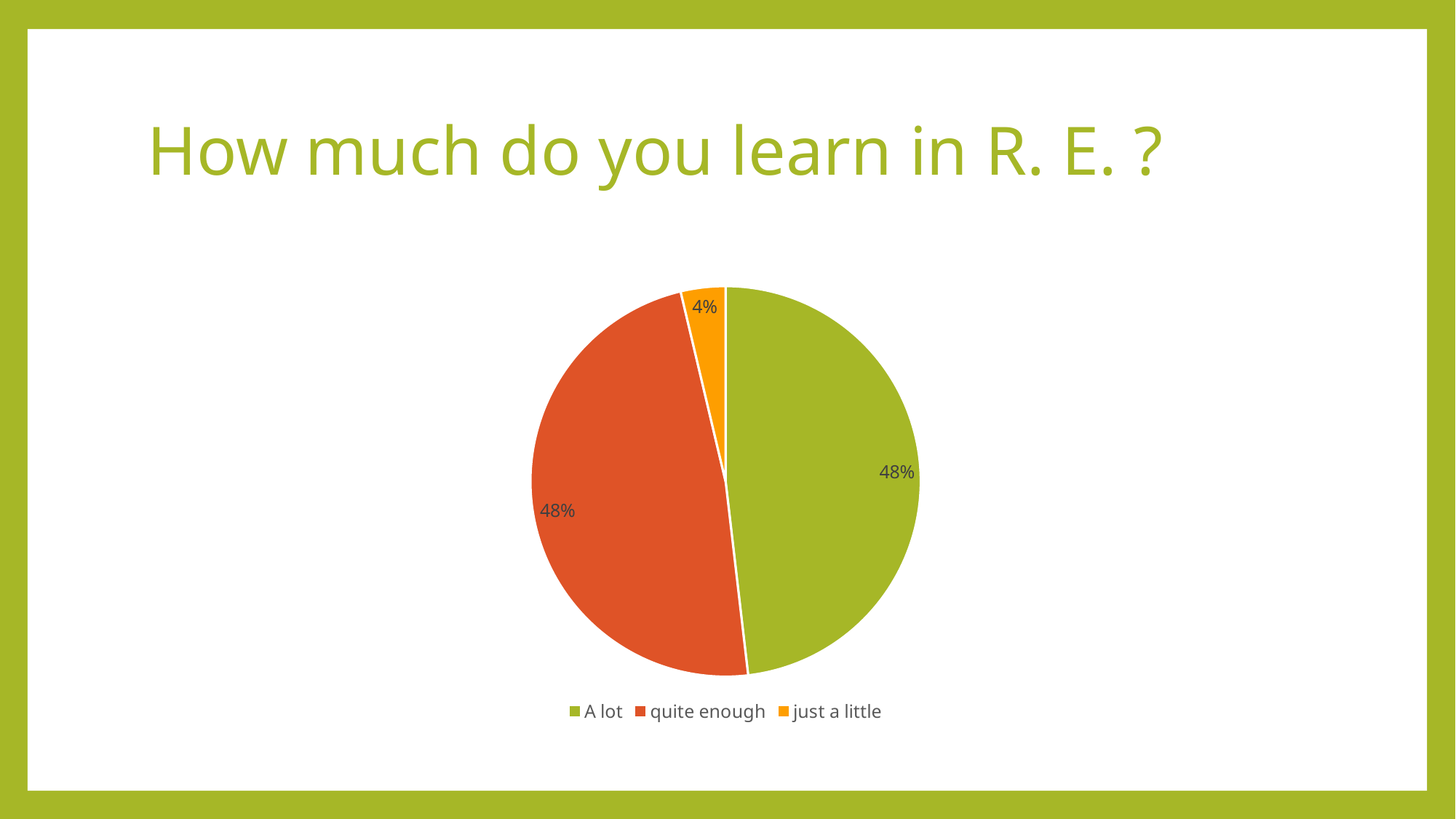
What colour is the slice for "just a little"? orange Which is larger, the slice for "A lot" or the slice for "just a little"? A lot What is the difference in percentage points between the "quite enough" slice and the "just a little" slice? 44 What kind of chart is shown on the slide? pie chart What share of the pie does "just a little" represent? 4% How many categories does the pie chart show? 3 What share of the pie does "quite enough" represent? 48% What share of the pie does "A lot" represent? 48% Is the share for "just a little" greater or less than 10%? less What is the title of the slide containing the pie chart? How much do you learn in R. E. ? Which category has the smallest slice of the pie? just a little